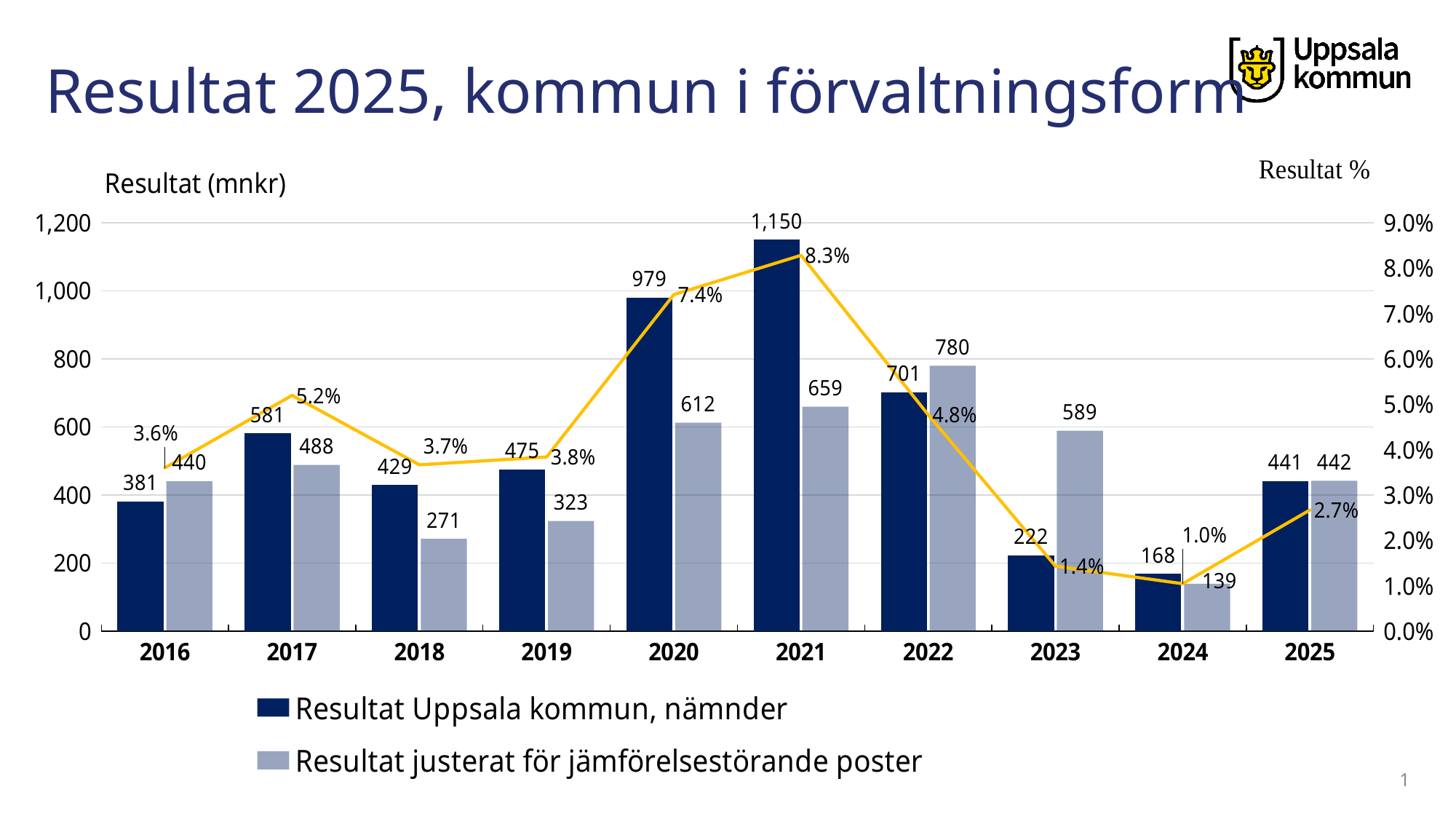
In which year is Resultat Uppsala kommun, nämnder highest? 2021 Does Resultat Uppsala kommun, nämnder rise or fall from 2021 to 2024? Fall What is the title of the slide? Resultat 2025, kommun i förvaltningsform What is the difference between Resultat Uppsala kommun, nämnder and Resultat justerat för jämförelsestörande poster in 2020? 367 What kind of chart is shown on the slide? Bar chart combined with a line What percentage does the Resultat % line show for 2021? 8.3% What is the value of Resultat justerat för jämförelsestörande poster for 2022? 780 In which year is Resultat justerat för jämförelsestörande poster lowest? 2024 In 2023, which is larger: Resultat Uppsala kommun, nämnder or Resultat justerat för jämförelsestörande poster? Resultat justerat för jämförelsestörande poster How many years are shown on the x axis? 10 What is the value of Resultat Uppsala kommun, nämnder for 2021? 1,150 How many series does the legend list? 2